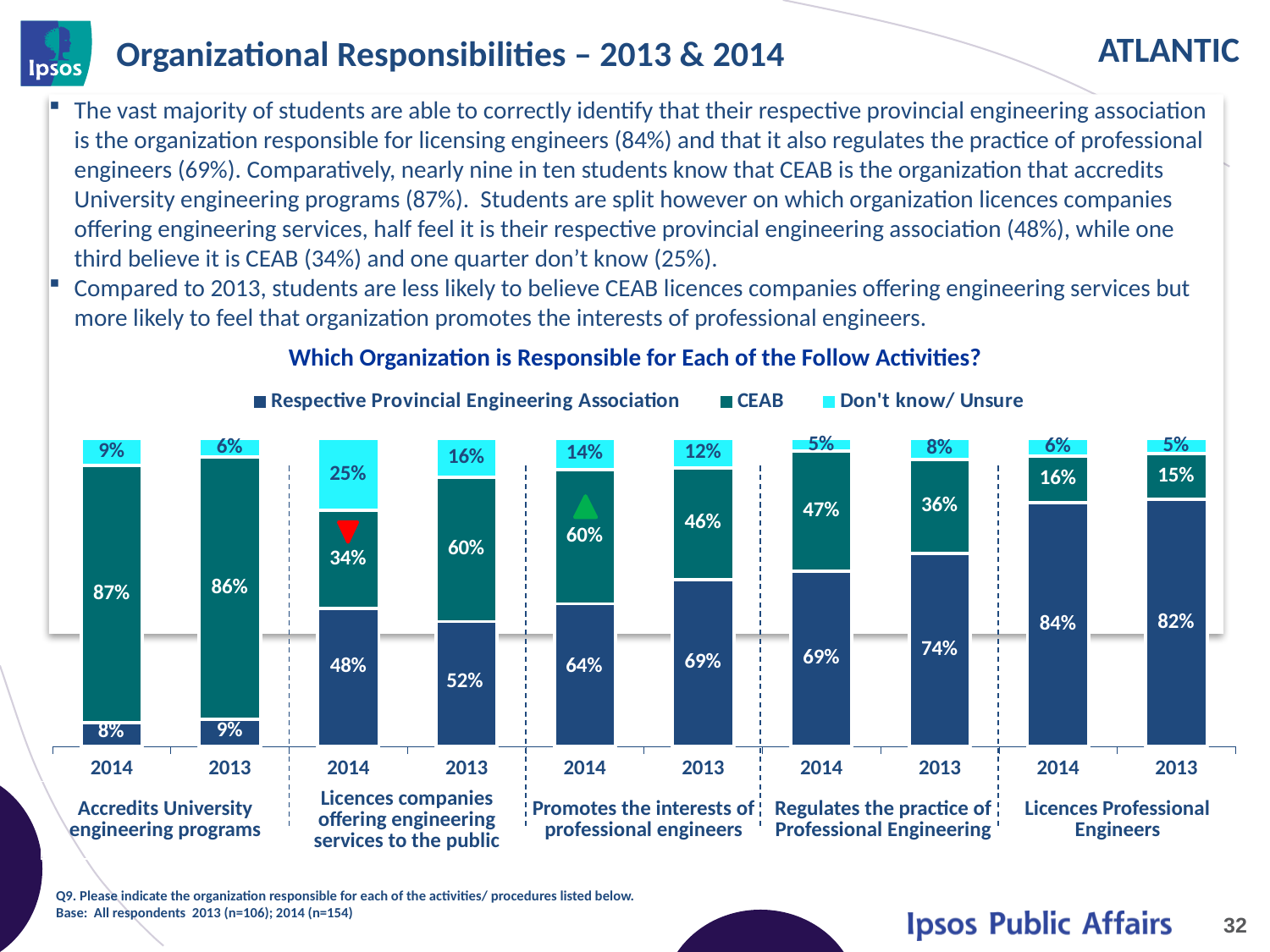
Across all bars, which activity and year has the highest Respective Provincial Engineering Association value? Licences Professional Engineers, 2014 In 2014, what share of students said their Respective Provincial Engineering Association licences Professional Engineers? 84% Which is larger: the Respective Provincial Engineering Association value for 'Regulates the practice of Professional Engineering' in 2014 or in 2013? 2013 What is the CEAB value for 'Promotes the interests of professional engineers' in 2013? 46% What is the Don't know/ Unsure value for 'Licences companies offering engineering services to the public' in 2014? 25% What type of chart is shown on the slide? Stacked bar chart How many bars are plotted in the chart? 10 Which activity and year has the lowest Don't know/ Unsure value? Regulates the practice of Professional Engineering, 2014 (and Licences Professional Engineers, 2013) What percentage of students in 2013 said the Respective Provincial Engineering Association regulates the practice of Professional Engineering? 74% How many series does the legend list? 3 What percentage of students in 2014 said CEAB accredits University engineering programs? 87% What is the difference between the CEAB values for 'Licences companies offering engineering services to the public' in 2013 and 2014? 26%